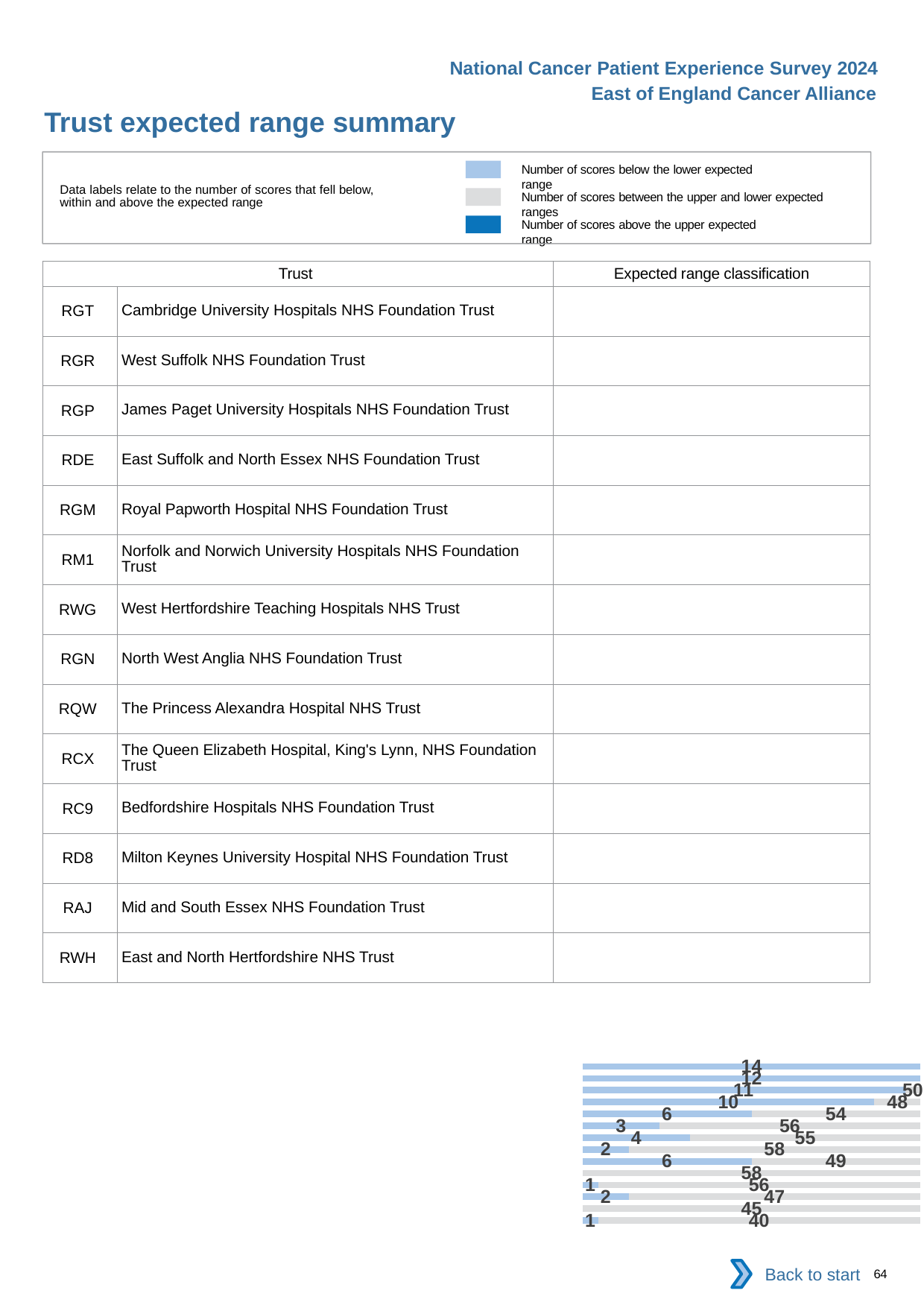
According to the legend, what does the dark blue colour in the chart represent? Number of scores above the upper expected range How many entries does the legend at the top of the slide list for the chart? 3 According to the legend, what does the light blue colour in the chart represent? Number of scores below the lower expected range What is the smallest data label printed on the chart? 1 What kind of chart is shown at the bottom right of the slide? bar chart What is the largest data label printed on the chart? 58